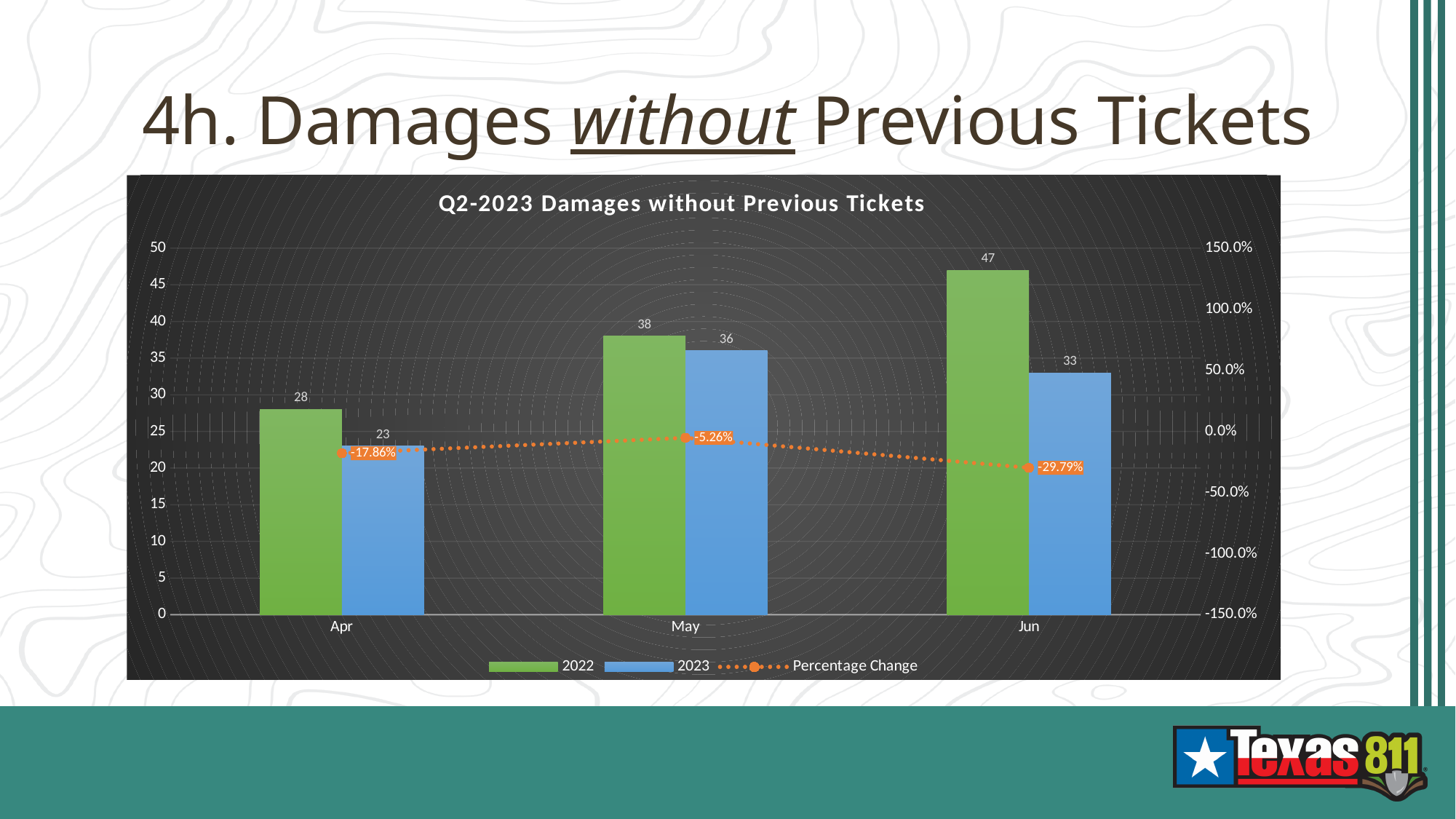
What is the 2023 value for Jun? 33 Which is larger for Apr, the 2022 value or the 2023 value? 2022 How many months are shown on the x axis? 3 Which month has the lowest 2023 value? Apr What is the Percentage Change value for Jun? -29.79% What is the difference between the 2022 and 2023 values for Jun? 14 What is the Percentage Change value for Apr? -17.86% What is the 2022 value for May? 38 How many series does the legend list? 3 Which month has the highest 2022 value? Jun What kind of chart is used for the 2022 and 2023 series? Bar chart What is the title of the chart? Q2-2023 Damages without Previous Tickets